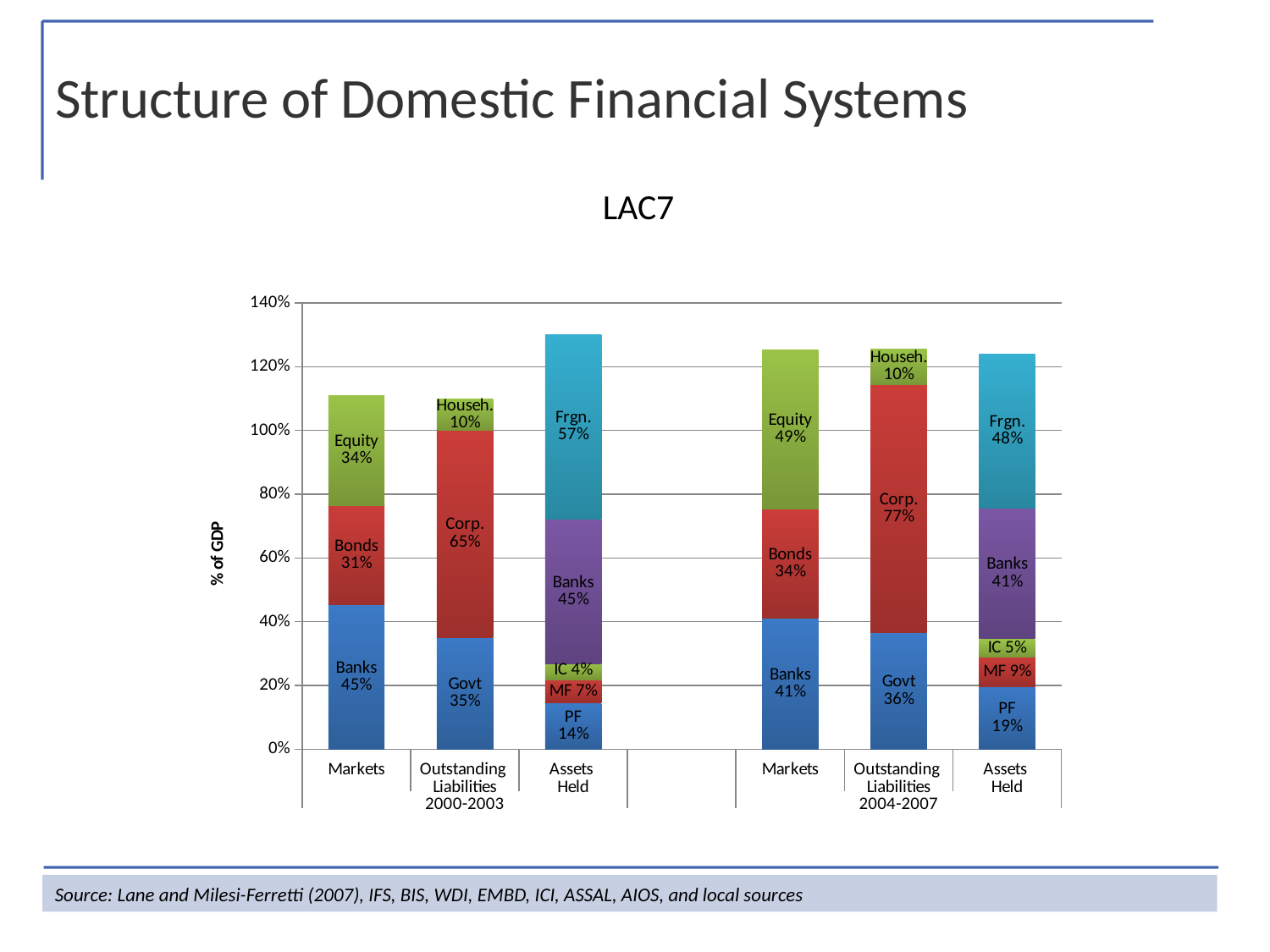
What is the title of the chart? LAC7 What is the difference between the Equity value in Markets 2004-2007 and the Equity value in Markets 2000-2003? 15% Is the total height of the Assets Held bar for 2000-2003 greater or less than 120%? greater What is the Banks share of GDP in the Markets bar for 2000-2003? 45% What is the Corp. value in the Outstanding Liabilities bar for 2004-2007? 77% What is the PF value in the Assets Held bar for 2004-2007? 19% What is the total of the stacked Markets bar for 2000-2003? 110% What is the Frgn. value in the Assets Held bar for 2000-2003? 57% How many stacked bars are plotted in the chart? 6 What kind of chart is shown on the slide? Stacked bar chart What is the total of the stacked Outstanding Liabilities bar for 2000-2003? 110% Which is larger: the Corp. value in Outstanding Liabilities 2000-2003 or in 2004-2007? 2004-2007